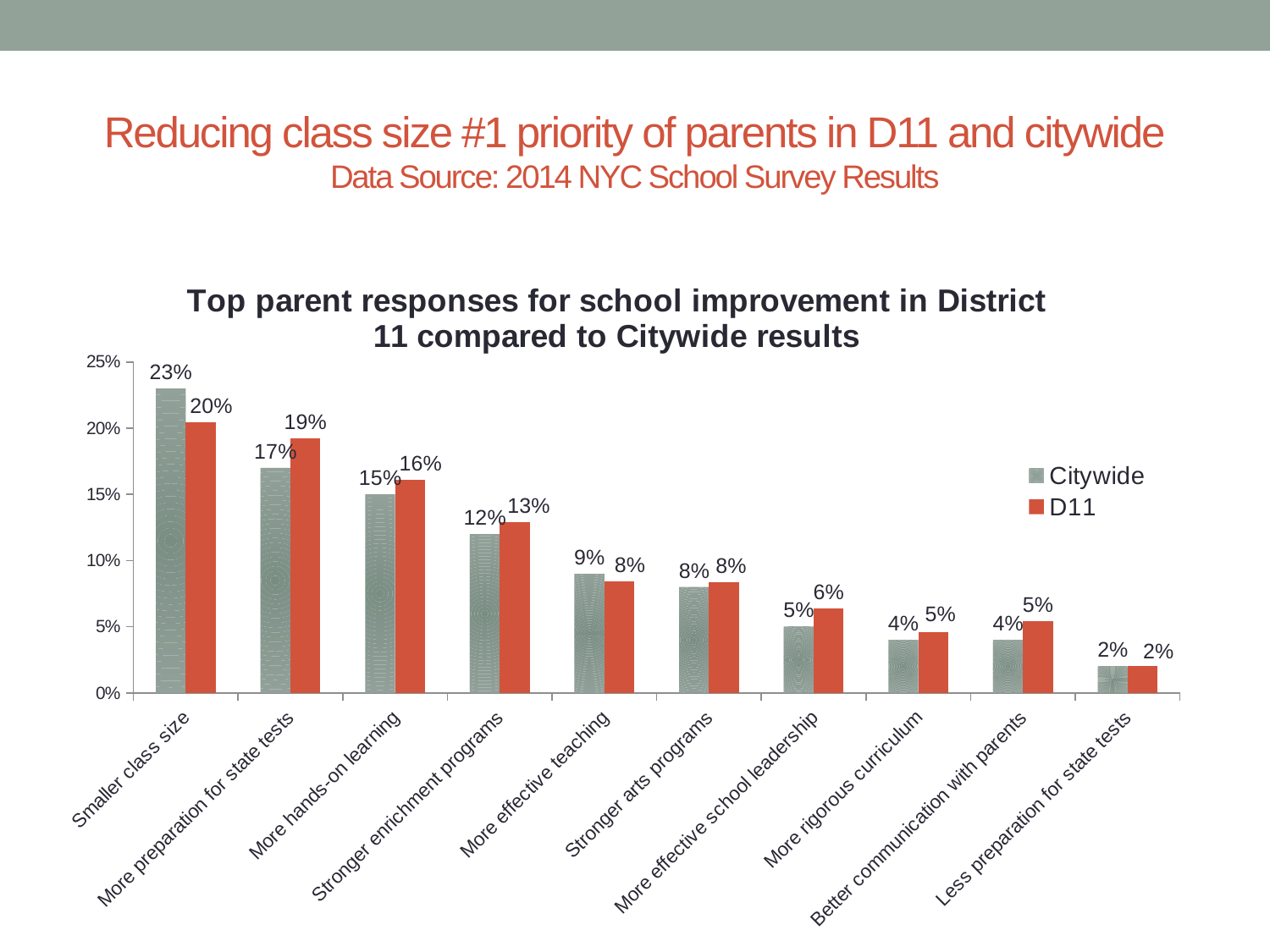
What is the D11 value for Stronger enrichment programs? 13% Do the Citywide values generally rise or fall from left to right along the x axis? Fall What kind of chart is shown on the slide? Bar chart Which is larger for More hands-on learning, the Citywide value or the D11 value? D11 How many series does the legend list? 2 What is the difference between the Citywide and D11 values for Smaller class size? 3% Which is larger for More effective teaching, the Citywide value or the D11 value? Citywide Which category has the lowest Citywide value? Less preparation for state tests What is the Citywide value for Smaller class size? 23% Which category has the highest D11 value? Smaller class size What is the D11 value for More preparation for state tests? 19% How many categories are shown on the x axis? 10